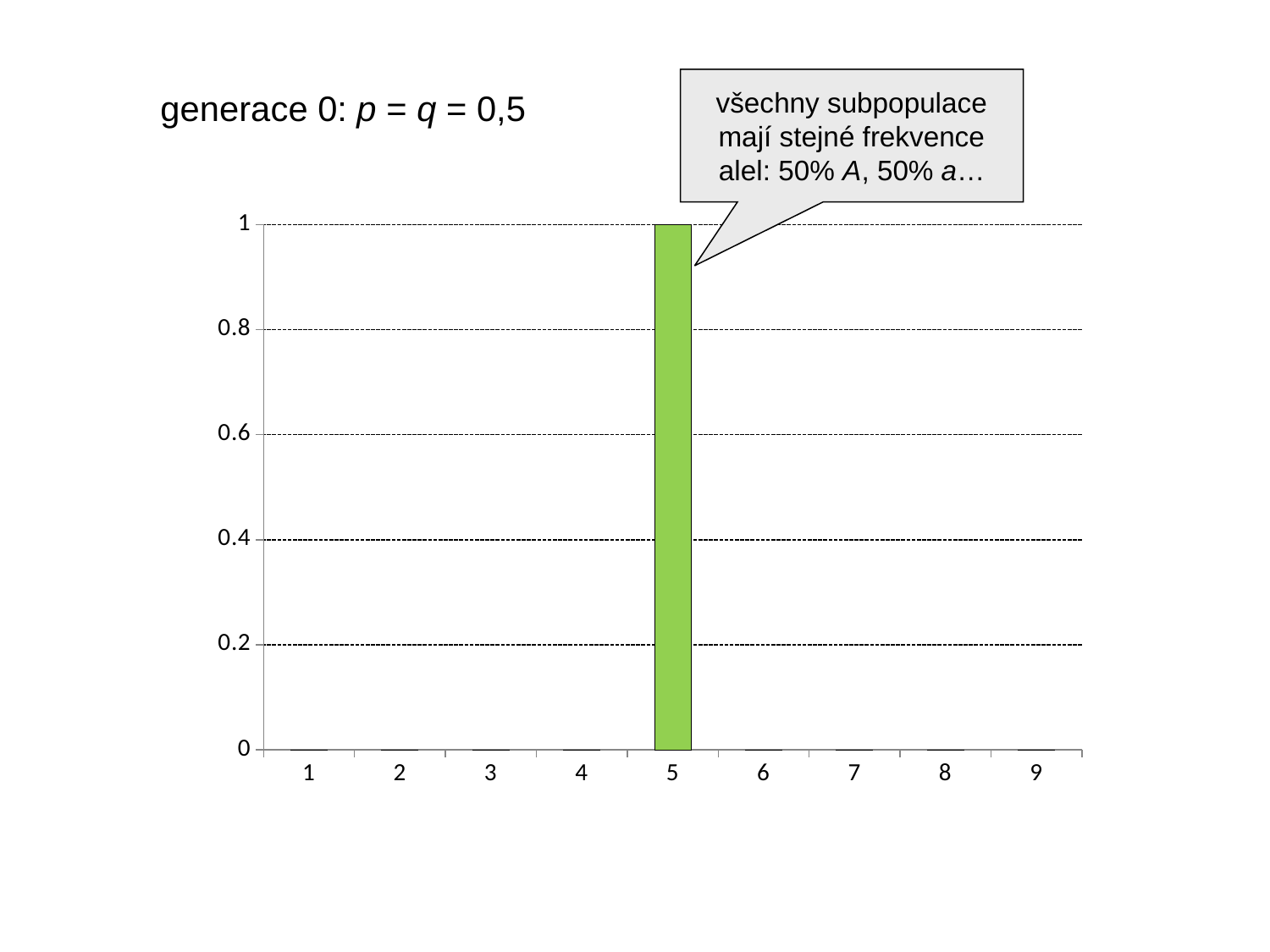
What is the highest value shown on the y axis of the chart? 1 What is the value for category 3 in the chart? 0 How many categories are shown on the x axis of the chart? 9 What colour is the bar for category 5? green What is the difference between the value for category 5 and the value for category 1? 1 Is the value for category 5 greater or less than 0.8? greater Which is larger, the value for category 5 or the value for category 6? category 5 Which category has the highest bar in the chart? 5 How many categories in the chart have a visible bar above 0? 1 What kind of chart is shown on the slide? bar chart Is the value for category 7 greater or less than 0.2? less What is the value of the bar for category 5? 1